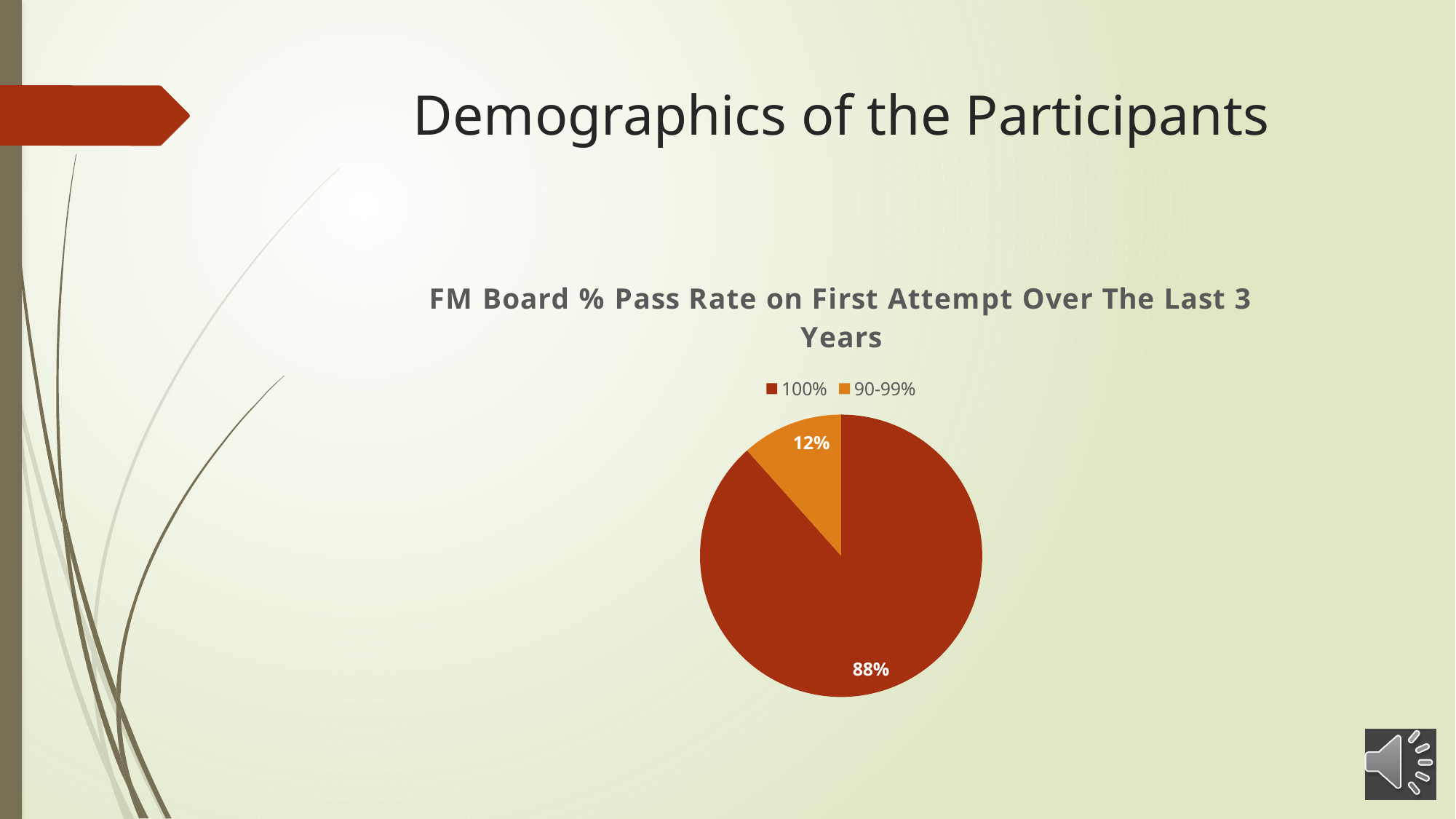
What colour is the slice for the "90-99%" category? orange What share of the pie does the "100%" category take? 88% Which slice is larger, "100%" or "90-99%"? 100% What is the difference in percentage points between the "100%" slice and the "90-99%" slice? 76 What is the title of the chart? FM Board % Pass Rate on First Attempt Over The Last 3 Years How many entries does the legend list? 2 What share of the pie does the "90-99%" category take? 12% What kind of chart is shown on the slide? pie chart Which category has the smallest slice of the pie? 90-99% How many categories does the pie chart show? 2 Which category has the largest slice of the pie? 100%